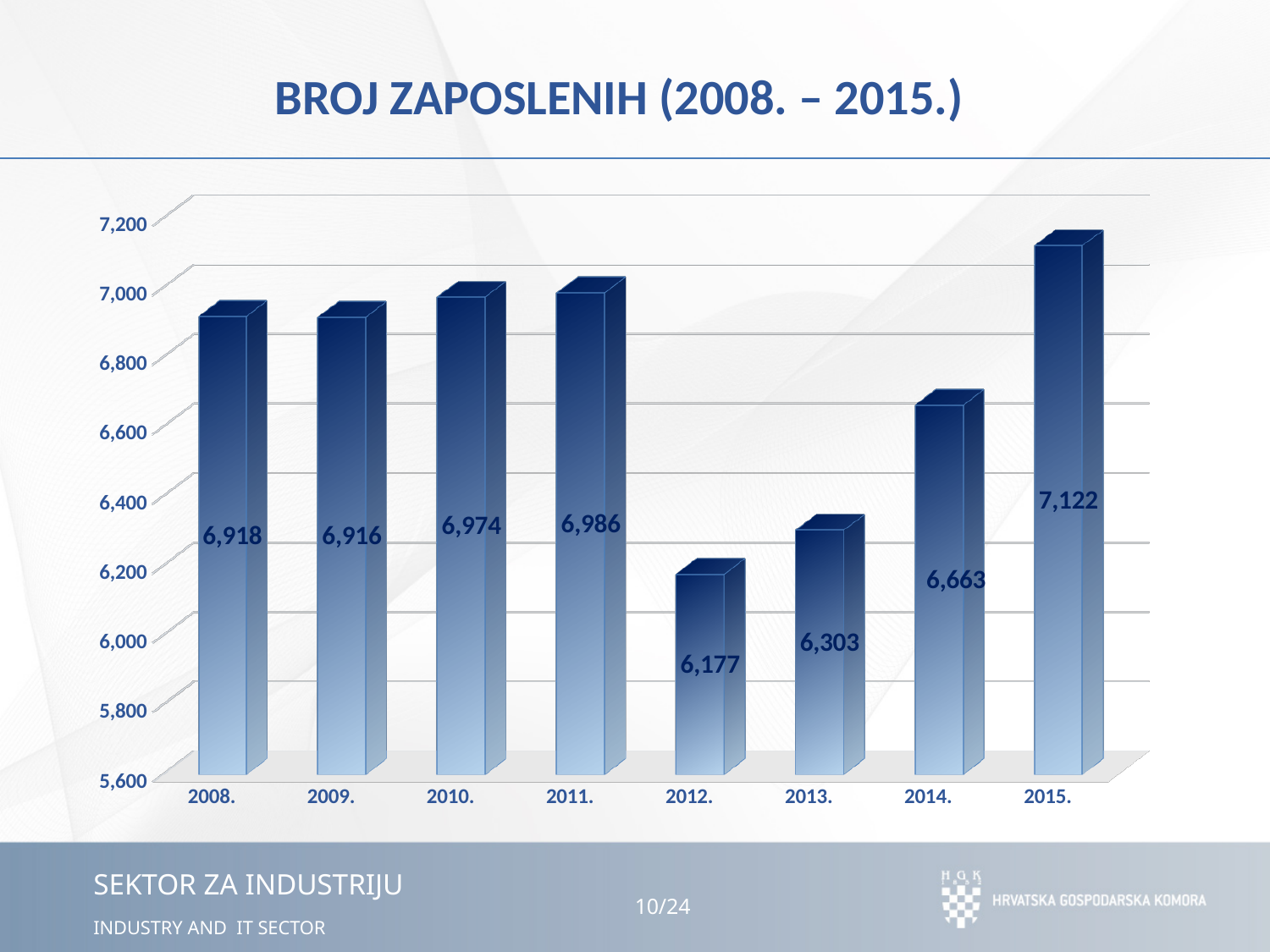
How many years are shown on the x axis of the chart? 8 Which year has the highest value in the chart? 2015. What is the difference between the values for 2015. and 2012.? 945 What is the value for 2015. in the chart? 7,122 Is the value for 2013. greater or less than 6,400? less Which is larger, the value for 2011. or the value for 2014.? 2011. What is the difference between the values for 2014. and 2013.? 360 What is the value for 2012. in the chart? 6,177 What kind of chart is shown on the slide? bar chart What is the value for 2010. in the chart? 6,974 What is the title of the chart on the slide? BROJ ZAPOSLENIH (2008. – 2015.) Which year has the lowest value in the chart? 2012.